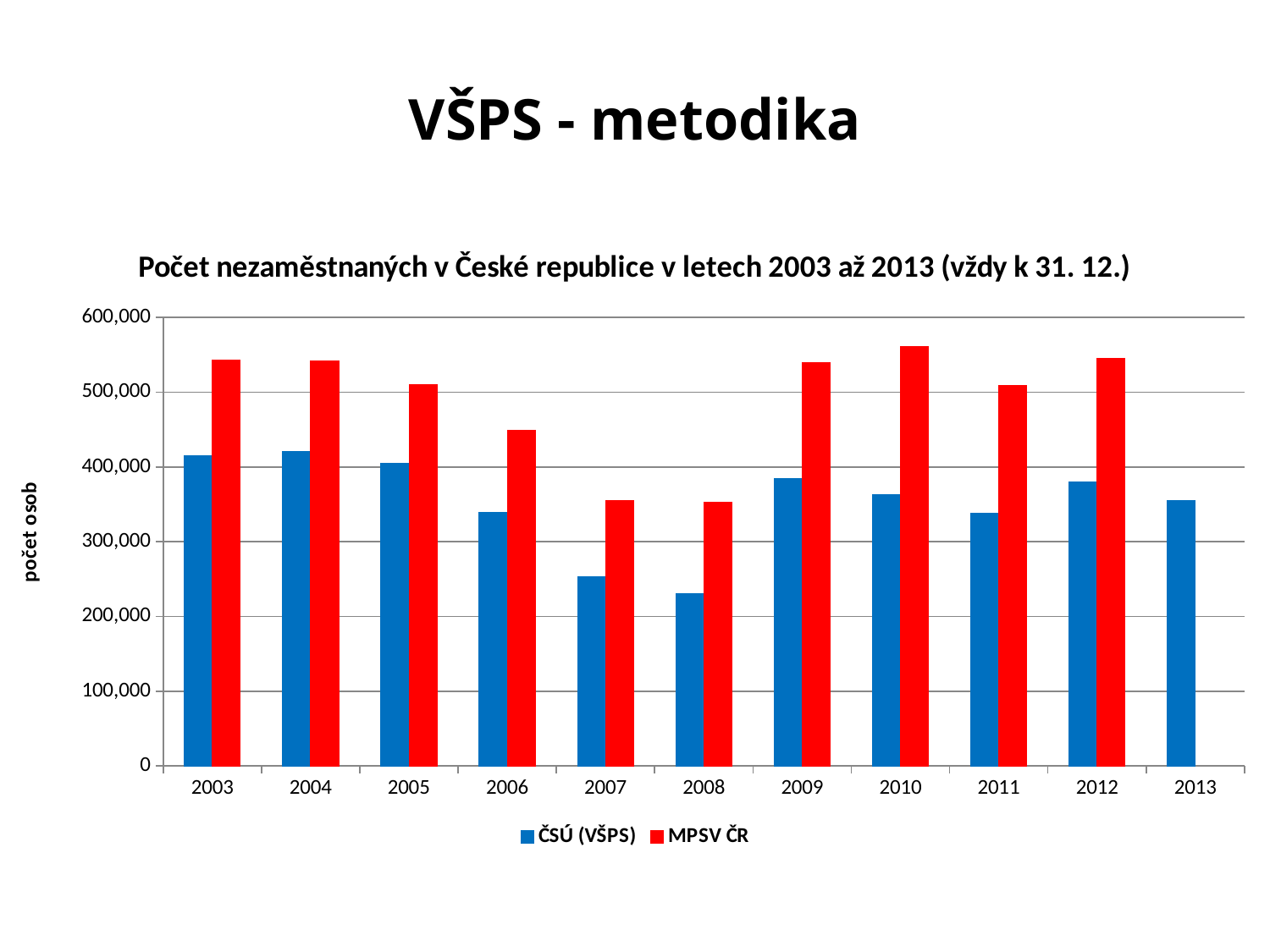
What kind of chart is shown on the slide? bar chart Which year has the lowest value for ČSÚ (VŠPS)? 2008 Is the ČSÚ (VŠPS) value for 2007 greater or less than 300,000? less Is the ČSÚ (VŠPS) value for 2013 greater or less than 300,000? greater How many years are shown on the x axis? 11 Do the ČSÚ (VŠPS) values rise or fall from 2004 to 2008? fall Is the MPSV ČR value for 2006 greater or less than 500,000? less In 2009, which series has the larger value, ČSÚ (VŠPS) or MPSV ČR? MPSV ČR What is the label on the vertical axis? počet osob Which year has the highest value for MPSV ČR? 2010 How many series does the legend list? 2